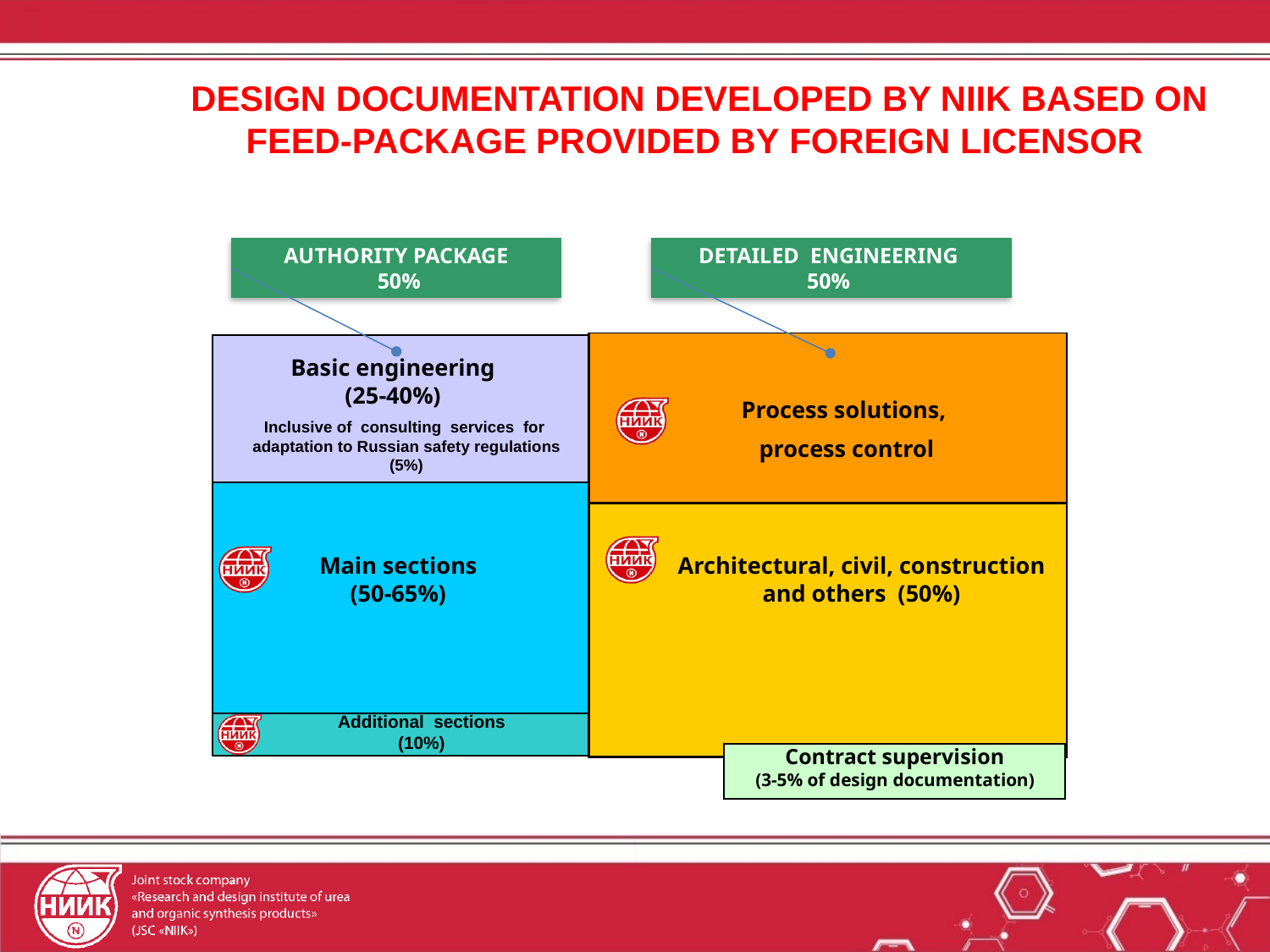
What percentage is given for Architectural, civil, construction and others? 50% Which has the larger printed percentage, Additional sections or Architectural, civil, construction and others? Architectural, civil, construction and others What percentage is given for Additional sections? 10% What percentage range is given for Basic engineering? 25-40% What percentage of design documentation is given for Contract supervision? 3-5% What percentage range is given for Main sections? 50-65% What percentage is given for consulting services for adaptation to Russian safety regulations? 5% What percentage is shown for the Authority Package? 50% What colour is the Main sections block? Blue Which two top-level packages are shown in the green boxes? Authority Package and Detailed Engineering What percentage is shown for Detailed Engineering? 50%